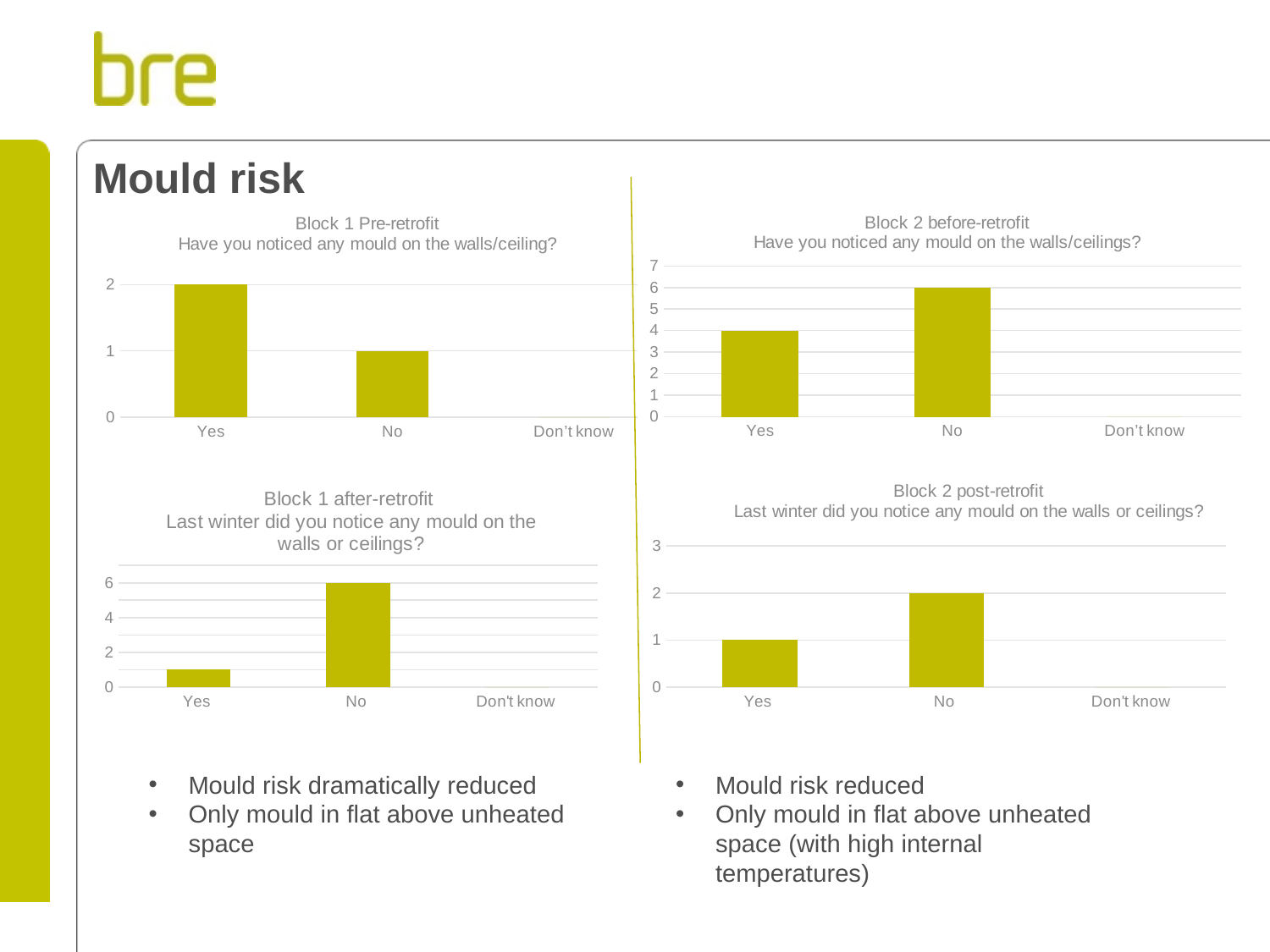
In the Block 2 post-retrofit chart, what is the value for No? 2 In the Block 2 before-retrofit chart, what is the value for Yes? 4 In the Block 1 Pre-retrofit chart, what is the value for Yes? 2 In the Block 2 before-retrofit chart, what is the value for No? 6 In the Block 1 after-retrofit chart, what is the value for No? 6 What type of chart is the Block 1 after-retrofit chart? Bar chart In the Block 1 after-retrofit chart, is the value for Yes greater or less than 2? less In the Block 2 before-retrofit chart, what is the difference between the No and Yes values? 2 In the Block 2 post-retrofit chart, which category has the highest value? No In the Block 1 Pre-retrofit chart, which category has the highest value? Yes How many categories are shown on the x axis of the Block 2 before-retrofit chart? 3 In the Block 1 Pre-retrofit chart, what is the value for No? 1